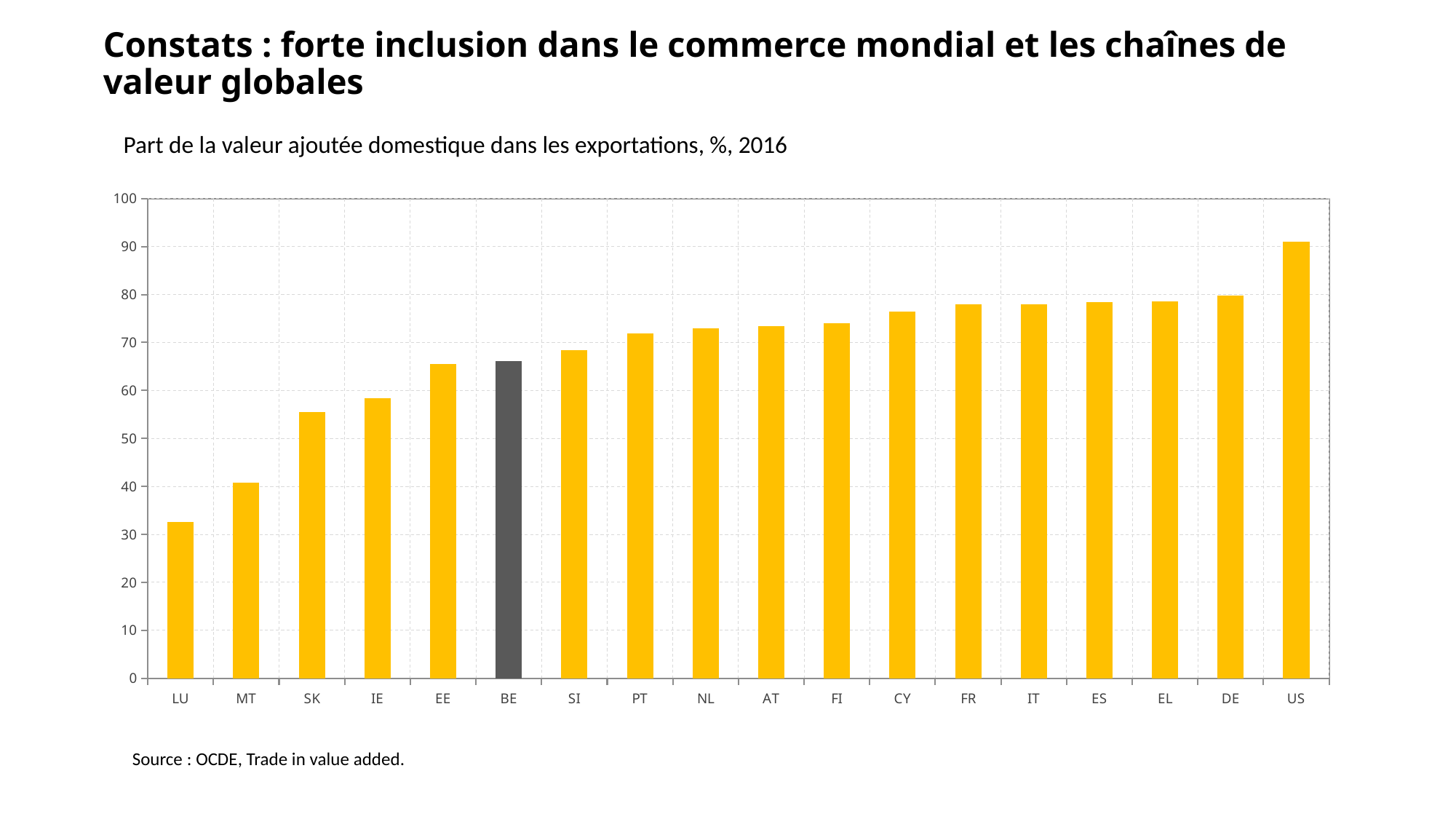
Which country has the lowest share of domestic value added in exports? LU How many countries are shown on the x axis of the chart? 18 Which has a larger value, BE or DE? DE Is the value for LU greater or less than 40? less Which country has the highest share of domestic value added in exports? US Is the value for BE greater or less than 60? greater What kind of chart is shown on the slide? bar chart Is the value for US greater or less than 90? greater Which country's bar is coloured dark grey instead of yellow? BE Do the values rise or fall from left to right along the x axis? rise Which has a larger value, MT or IE? IE